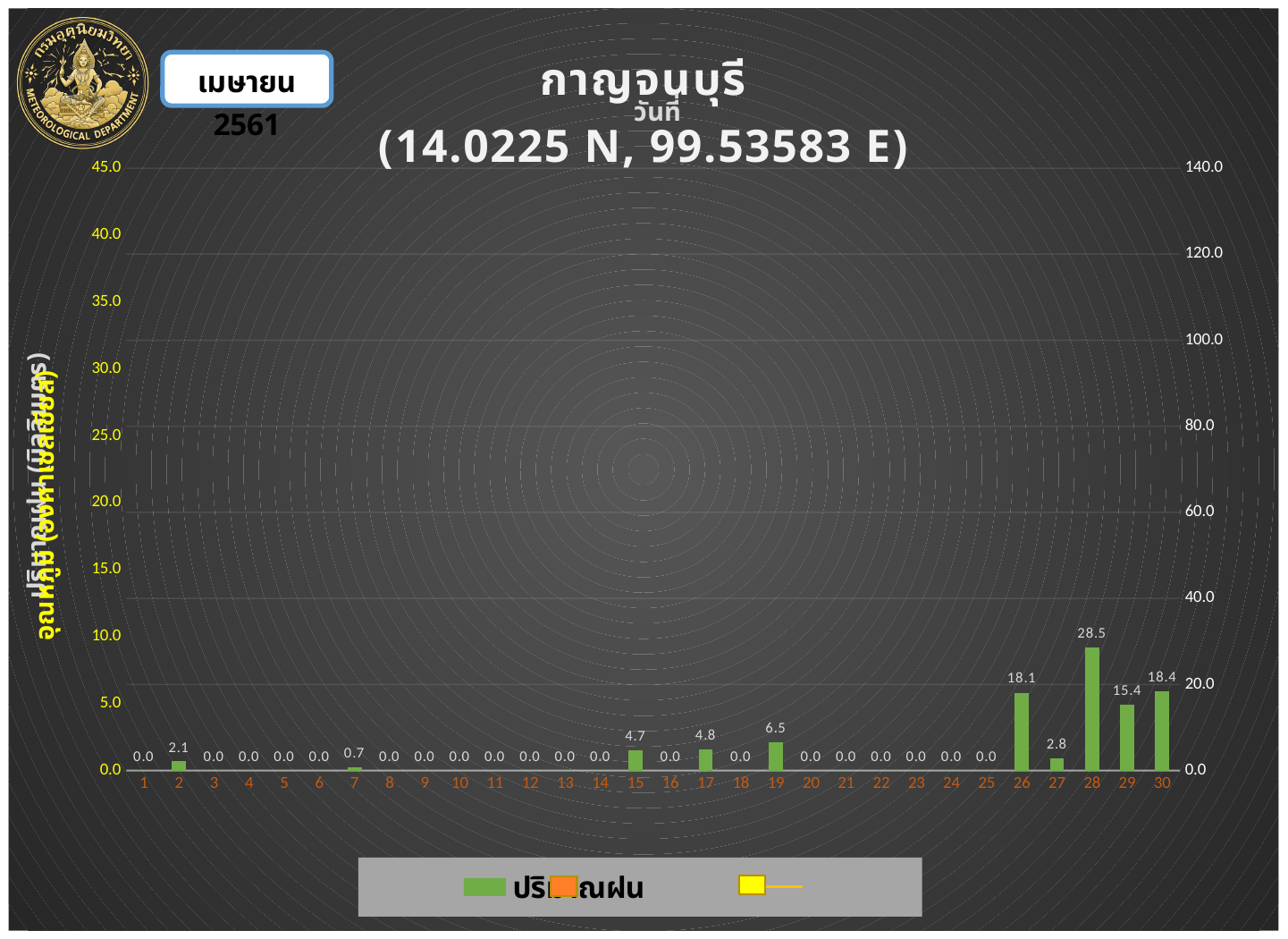
What is the rainfall value shown for day 26? 18.1 Which has a larger rainfall value, day 15 or day 17? day 17 What is the rainfall value shown for day 7? 0.7 Which day has the highest rainfall value? 28 What coordinates are given in the chart title? 14.0225 N, 99.53583 E What is the difference between the rainfall values for day 28 and day 30? 10.1 Which has a larger rainfall value, day 27 or day 29? day 29 How many days are shown on the x axis? 30 What is the difference between the rainfall values for day 26 and day 29? 2.7 What is the rainfall value shown for day 28? 28.5 What kind of chart is shown on the slide? bar chart What is the rainfall value shown for day 19? 6.5